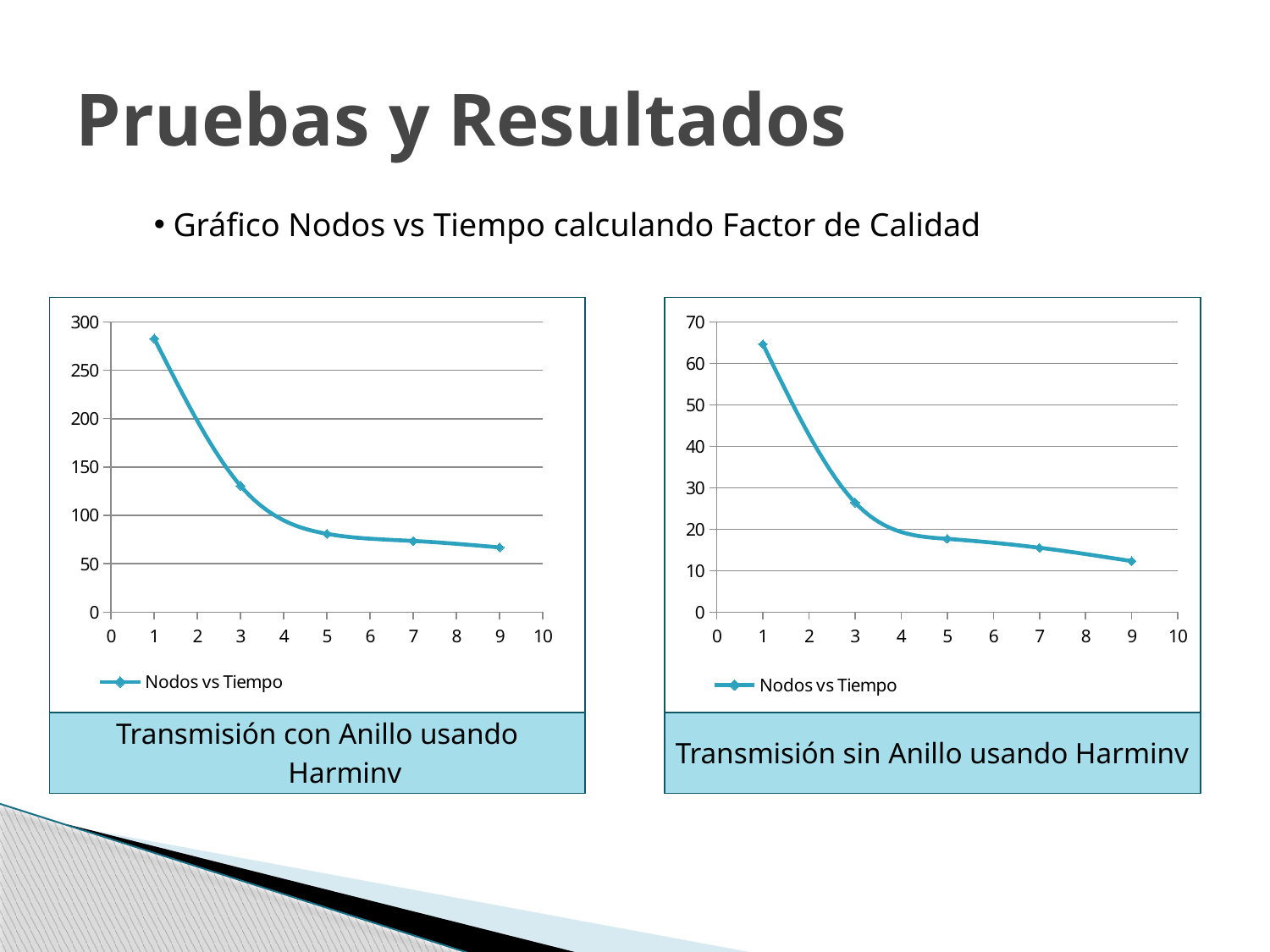
In the left chart, 'Transmisión con Anillo usando Harminv', how many data points are plotted? 5 In the left chart, 'Transmisión con Anillo usando Harminv', do the values rise or fall as x increases? fall What is the name of the series shown in the legend of the left chart, 'Transmisión con Anillo usando Harminv'? Nodos vs Tiempo What kind of chart is the left chart, 'Transmisión con Anillo usando Harminv'? line chart In the left chart, 'Transmisión con Anillo usando Harminv', is the value at x = 9 greater or less than 100? less In the right chart, 'Transmisión sin Anillo usando Harminv', do the values rise or fall as x increases? fall In the right chart, 'Transmisión sin Anillo usando Harminv', at which x value is the plotted value lowest? 9 In the right chart, 'Transmisión sin Anillo usando Harminv', how many series does the legend list? 1 In the left chart, 'Transmisión con Anillo usando Harminv', at which x value is the plotted value highest? 1 In the right chart, 'Transmisión sin Anillo usando Harminv', is the value at x = 1 greater or less than 60? greater In the left chart, 'Transmisión con Anillo usando Harminv', is the value at x = 1 greater or less than 250? greater